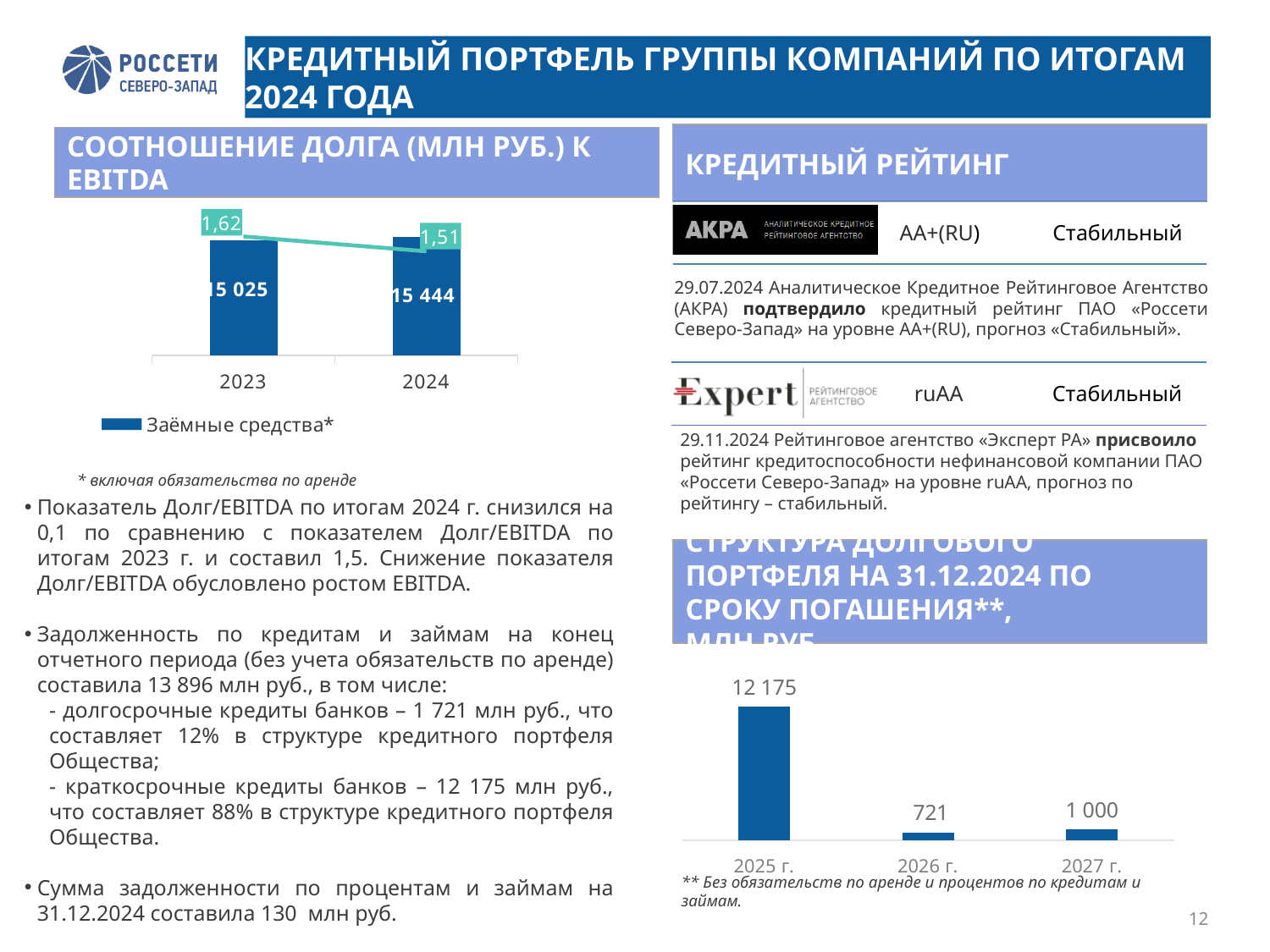
In the chart 'Соотношение долга (млн руб.) к EBITDA', what is the value of Заёмные средства for 2024? 15 444 In the chart 'Соотношение долга (млн руб.) к EBITDA', by how much did Заёмные средства increase from 2023 to 2024? 419 In the chart 'Соотношение долга (млн руб.) к EBITDA', what is the legend entry for the bars? Заёмные средства* In the chart 'Соотношение долга (млн руб.) к EBITDA', what is the Debt/EBITDA ratio shown for 2023? 1,62 In the chart 'Структура долгового портфеля на 31.12.2024 по сроку погашения', what is the difference between the values for 2027 г. and 2026 г.? 279 In the chart 'Соотношение долга (млн руб.) к EBITDA', what is the Debt/EBITDA ratio shown for 2024? 1,51 In the chart 'Структура долгового портфеля на 31.12.2024 по сроку погашения', which year has the lowest value? 2026 г. In the chart 'Соотношение долга (млн руб.) к EBITDA', what is the value of Заёмные средства for 2023? 15 025 In the chart 'Структура долгового портфеля на 31.12.2024 по сроку погашения', what is the value for 2026 г.? 721 In the chart 'Соотношение долга (млн руб.) к EBITDA', does the Debt/EBITDA line rise or fall from 2023 to 2024? fall In the chart 'Структура долгового портфеля на 31.12.2024 по сроку погашения', how many years are shown on the x axis? 3 In the chart 'Структура долгового портфеля на 31.12.2024 по сроку погашения', what is the value for 2025 г.? 12 175